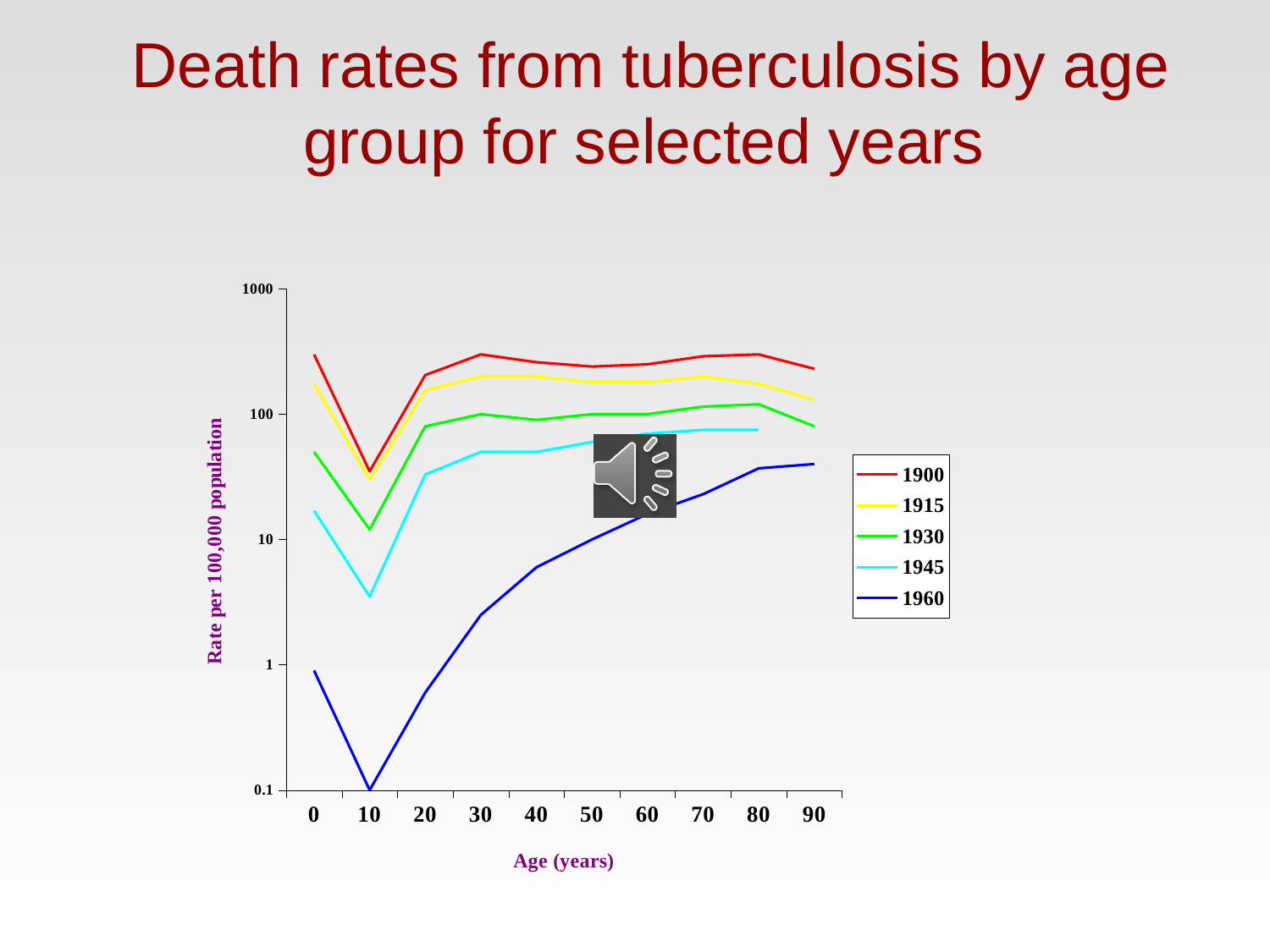
How many age groups are marked along the x axis? 10 What kind of chart is shown on the slide? line chart Which year's line has the highest death rates across the age groups? 1900 At age 50, which is larger: the value for 1900 or the value for 1960? 1900 Does the 1960 line rise or fall from age 10 to age 90? rise Is the value for 1900 at age 0 greater or less than 100? greater At which age is the 1960 line at its lowest point? 10 Is the value for 1960 at age 90 greater or less than 100? less How many series does the legend list? 5 Is the value for 1945 at age 10 greater or less than 10? less Which year's line has the lowest death rates across the age groups? 1960